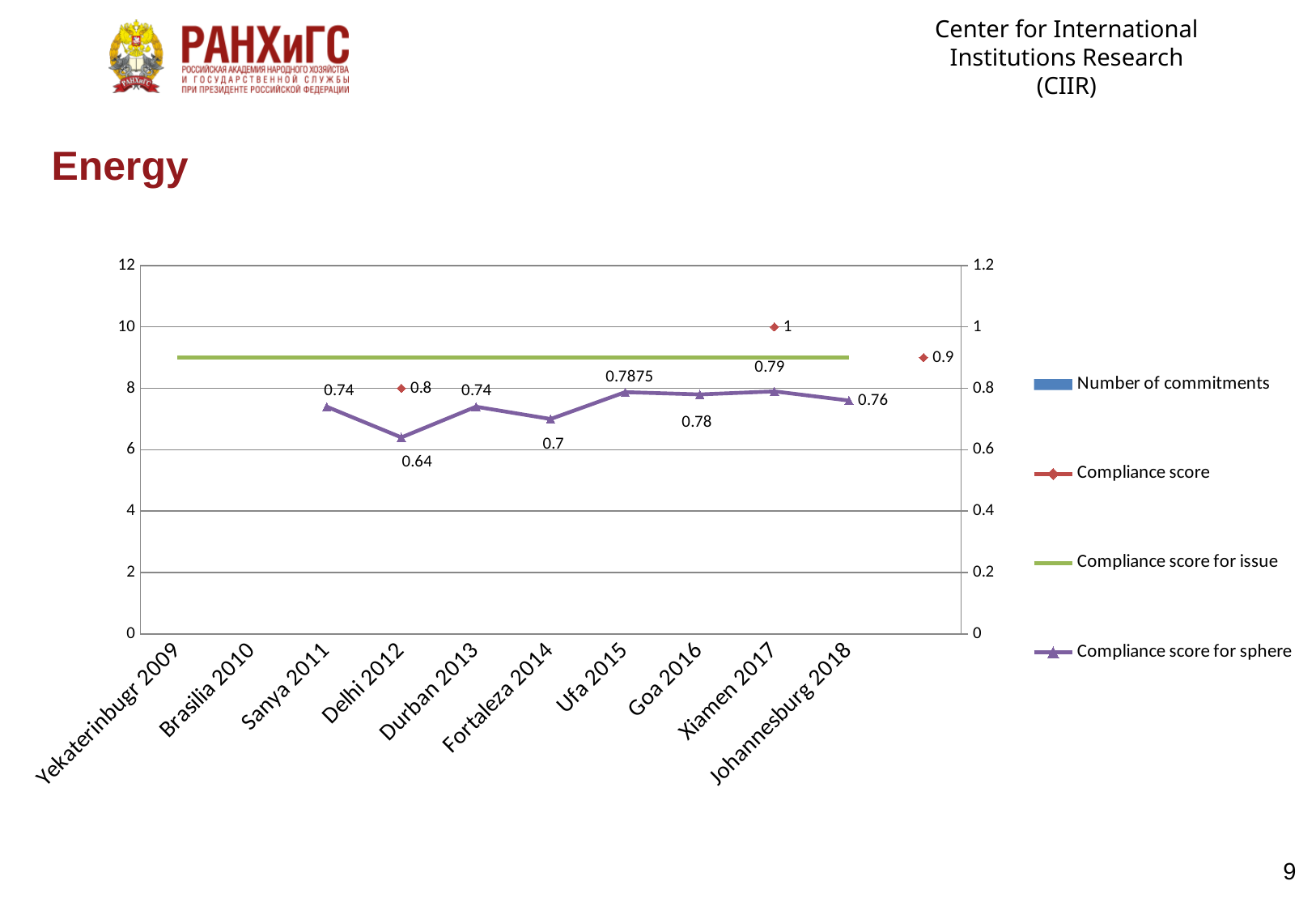
How many summits are listed on the x axis? 10 Which summit has the highest Compliance score for sphere? Xiamen 2017 How many series does the legend list? 4 What is the difference between the Compliance score for sphere at Xiamen 2017 and at Delhi 2012? 0.15 What is the Compliance score for sphere at Ufa 2015? 0.7875 Is the Compliance score for issue greater or less than 0.8? greater What is the Compliance score for sphere at Delhi 2012? 0.64 What is the Compliance score at Delhi 2012? 0.8 What kind of chart is shown on the slide? line chart What is the Compliance score at Xiamen 2017? 1 Which has a higher Compliance score for sphere, Goa 2016 or Johannesburg 2018? Goa 2016 Which summit has the lowest Compliance score for sphere? Delhi 2012